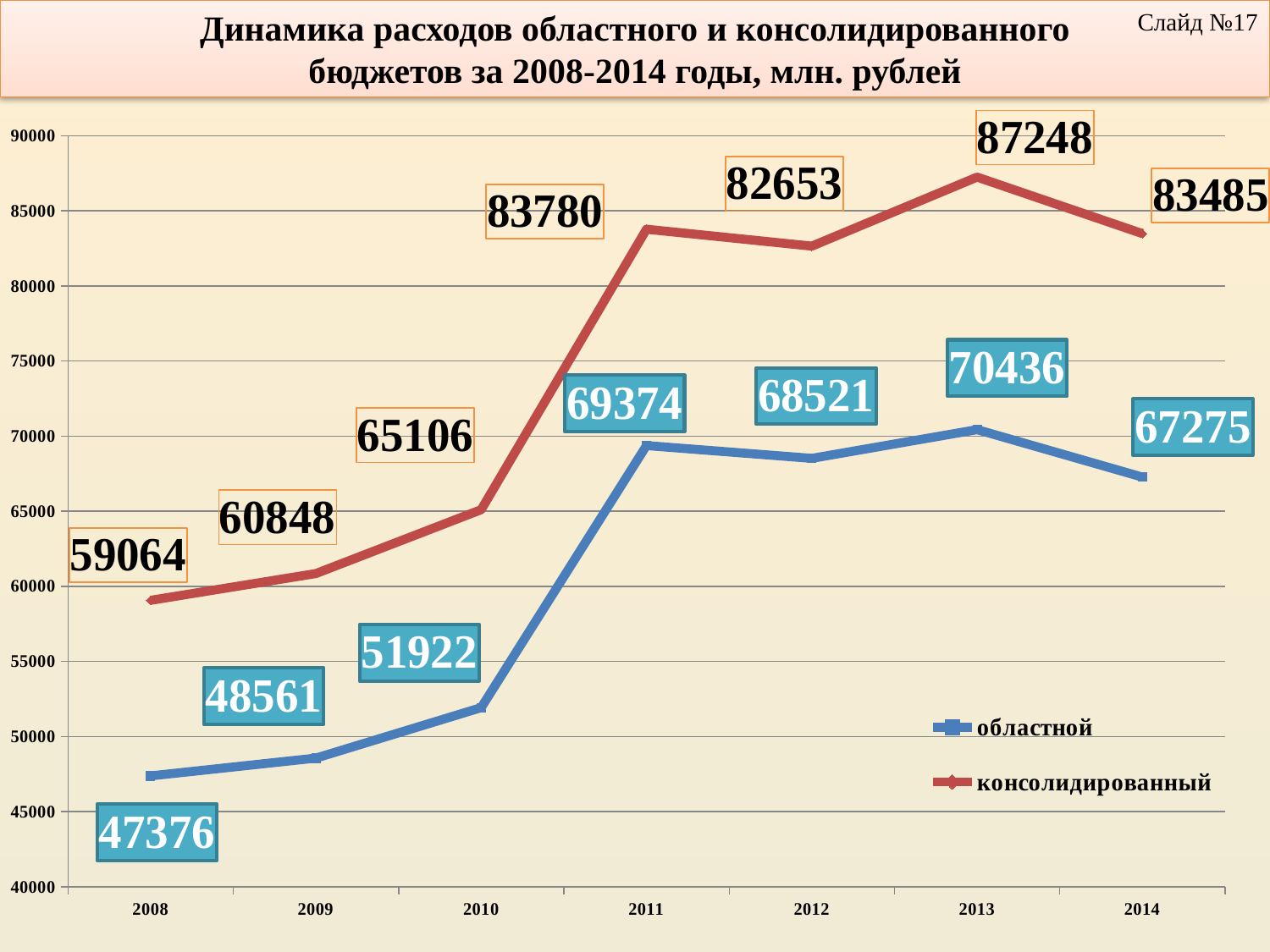
How many years are shown on the x axis? 7 What type of chart is shown on the slide? line chart What is the difference between the консолидированный and областной values in 2011? 14406 Which is larger: the областной value in 2013 or the областной value in 2012? 2013 In which year is the консолидированный series at its highest? 2013 Is the консолидированный value in 2010 greater or less than 70000? less What is the value of the областной series in 2008? 47376 Does the областной series rise or fall from 2008 to 2011? rise How many series does the legend list? 2 What is the value of the консолидированный series in 2013? 87248 What is the value of the областной series in 2014? 67275 In which year is the областной series at its lowest? 2008